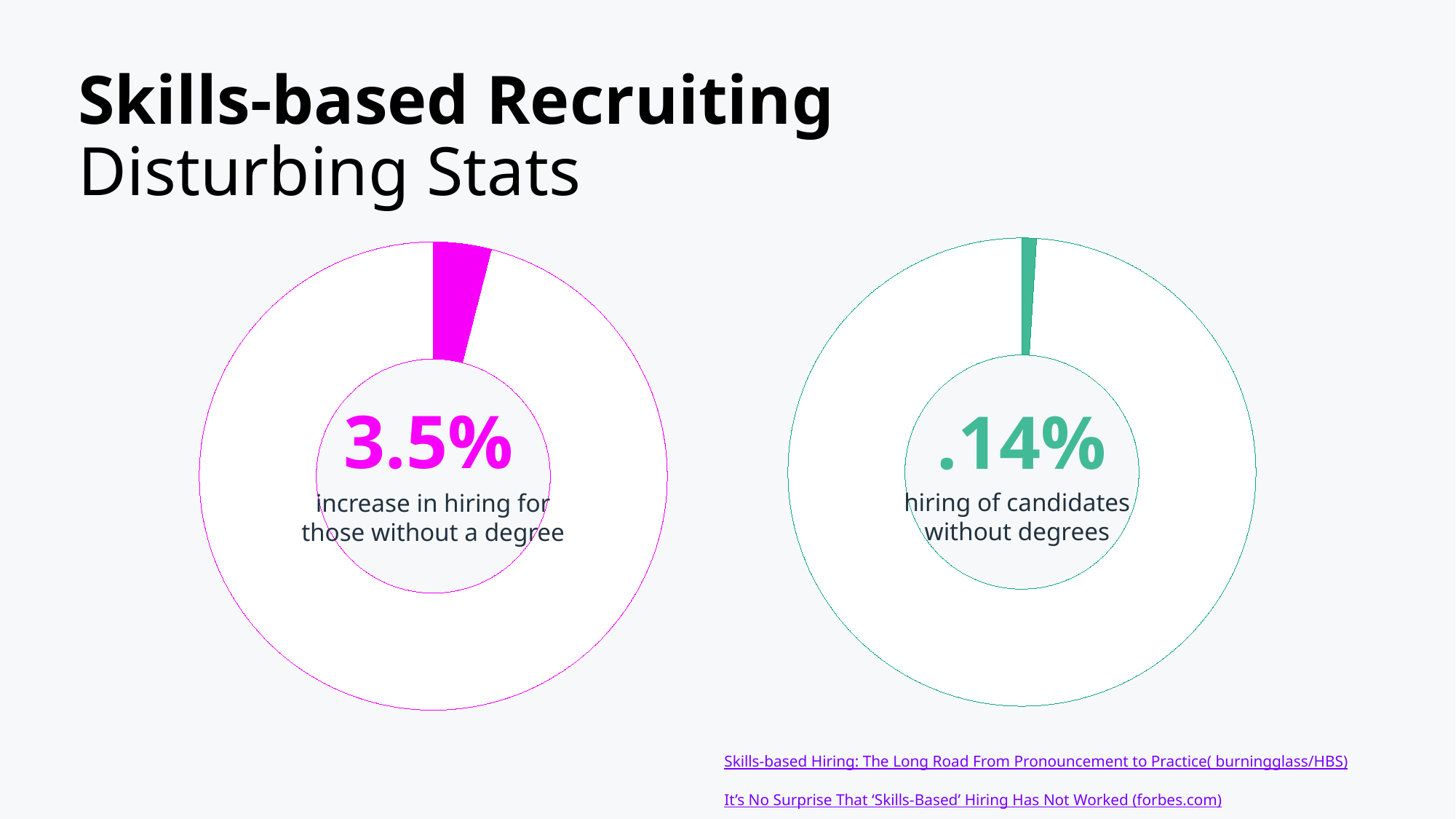
Which chart shows the larger value, the left chart (increase in hiring for those without a degree) or the right chart (hiring of candidates without degrees)? The left chart On the right chart, what percentage is shown in the centre of the donut? .14% What colour is the filled slice on the right chart? Green How many donut charts are on the slide? 2 What kind of chart is used on the left side of the slide? Donut (pie) chart On the left chart, is the filled slice's share of the donut greater or less than 50%? less What is the difference between the value on the left chart (3.5%) and the value on the right chart (.14%)? 3.36% On the right chart, what does the .14% figure represent according to the label? Hiring of candidates without degrees What kind of chart is used on the right side of the slide? Donut (pie) chart What colour is the filled slice on the left chart? Magenta (pink) On the left chart, what percentage is shown in the centre of the donut? 3.5% On the left chart, what does the 3.5% figure represent according to the label? Increase in hiring for those without a degree